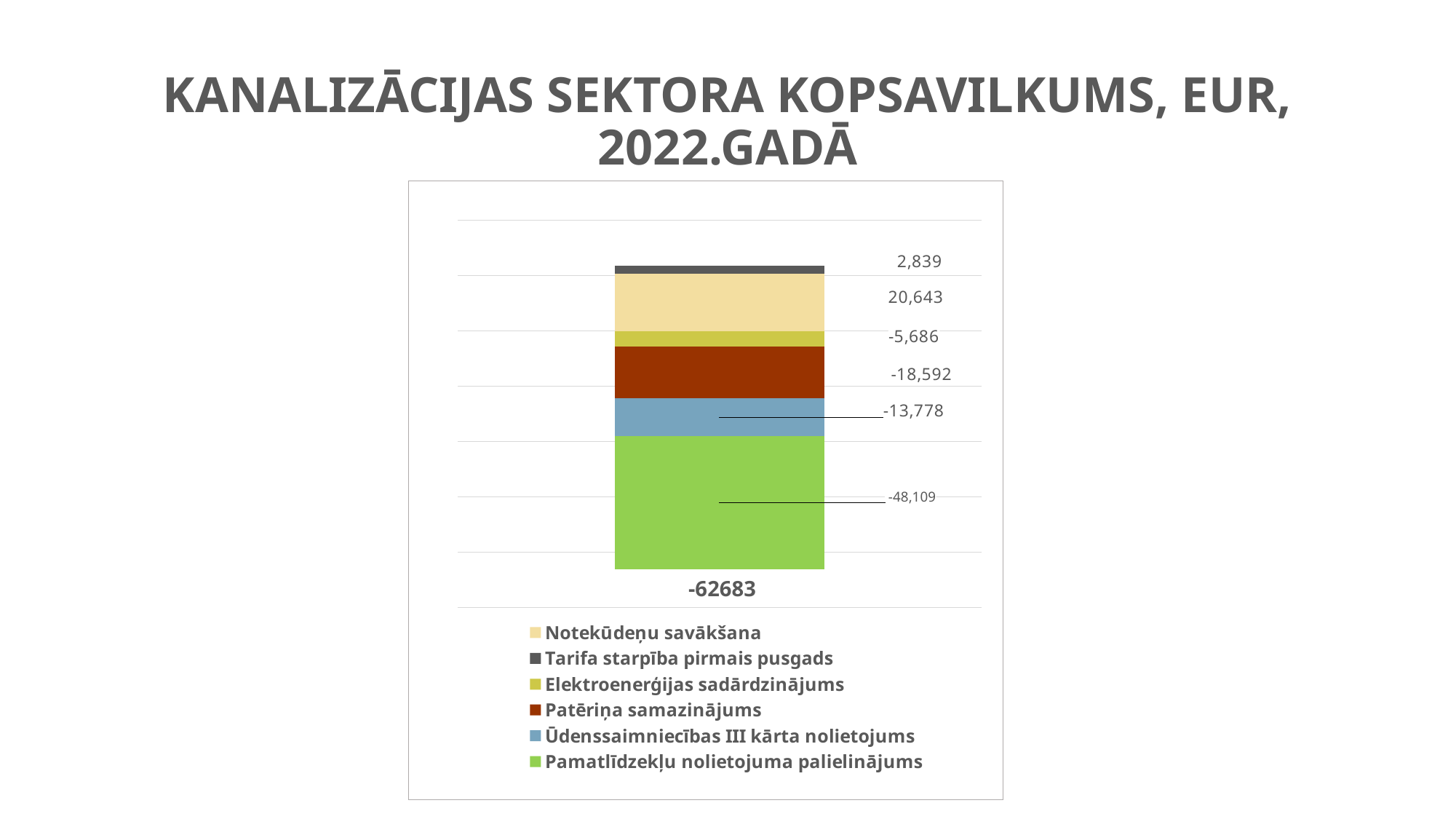
What is the title of the chart on the slide? KANALIZĀCIJAS SEKTORA KOPSAVILKUMS, EUR, 2022.GADĀ Which series has the highest value? Notekūdeņu savākšana What is the value for Notekūdeņu savākšana? 20,643 What is the value for Tarifa starpība pirmais pusgads? 2,839 What is the value for Ūdenssaimniecības III kārta nolietojums? -13,778 What kind of chart is shown on the slide? Stacked bar chart What is the difference between the values for Notekūdeņu savākšana and Tarifa starpība pirmais pusgads? 17,804 What is the value for Pamatlīdzekļu nolietojuma palielinājums? -48,109 What is the value for Elektroenerģijas sadārdzinājums? -5,686 Which series has the lowest value? Pamatlīdzekļu nolietojuma palielinājums How many series does the legend list? 6 What is the value for Patēriņa samazinājums? -18,592